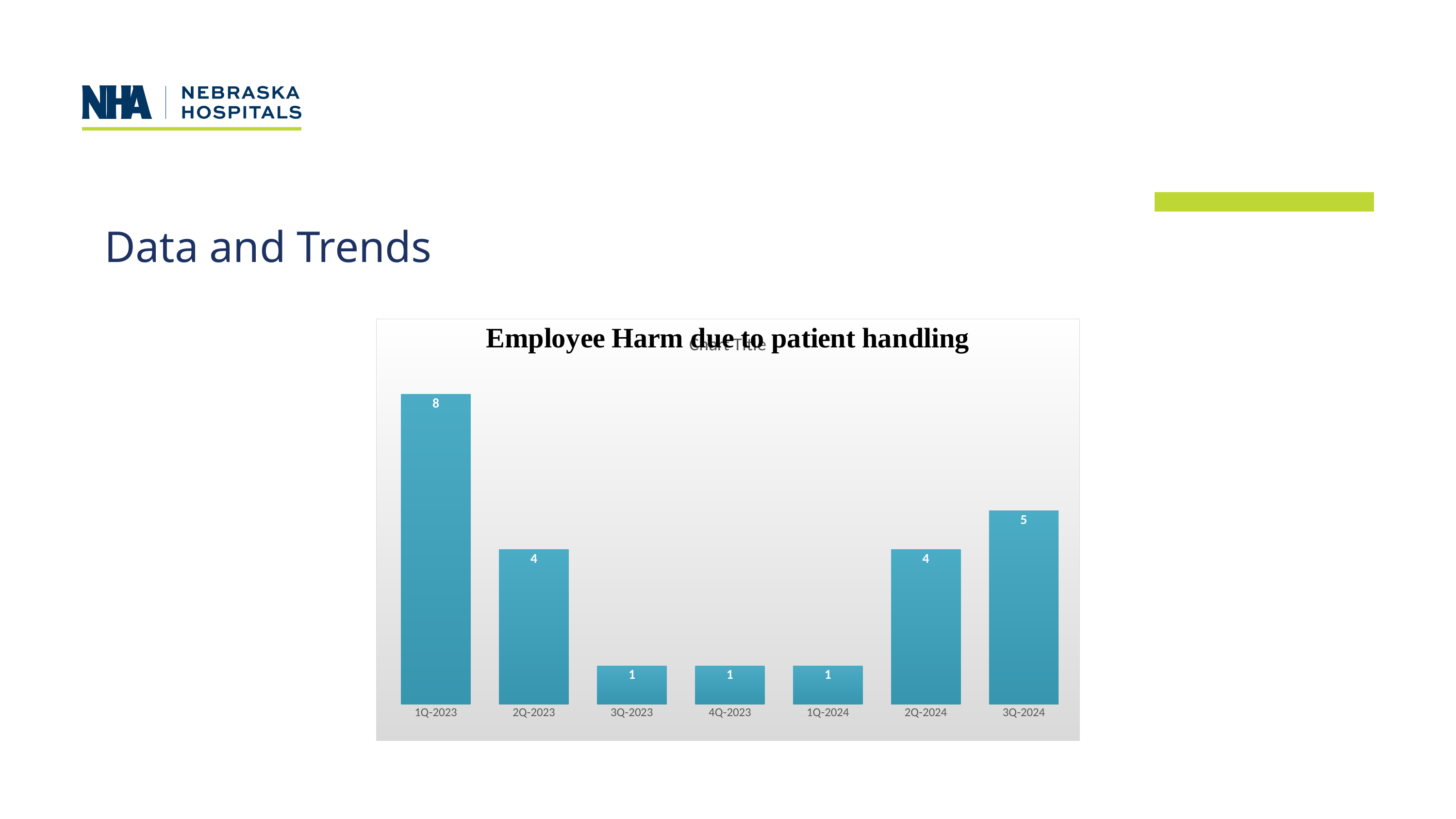
What kind of chart is shown on the slide? Bar chart What is the value for 2Q-2024? 4 What is the value for 1Q-2023? 8 Which is larger, the value for 3Q-2024 or the value for 2Q-2024? 3Q-2024 Which quarter has the highest value? 1Q-2023 What is the difference between the values for 3Q-2024 and 1Q-2024? 4 What is the title of the chart? Employee Harm due to patient handling Do the values rise or fall from 1Q-2024 to 3Q-2024? Rise How many quarters are shown on the x axis? 7 What is the value for 3Q-2024? 5 What is the difference between the values for 1Q-2023 and 2Q-2023? 4 What is the value for 4Q-2023? 1